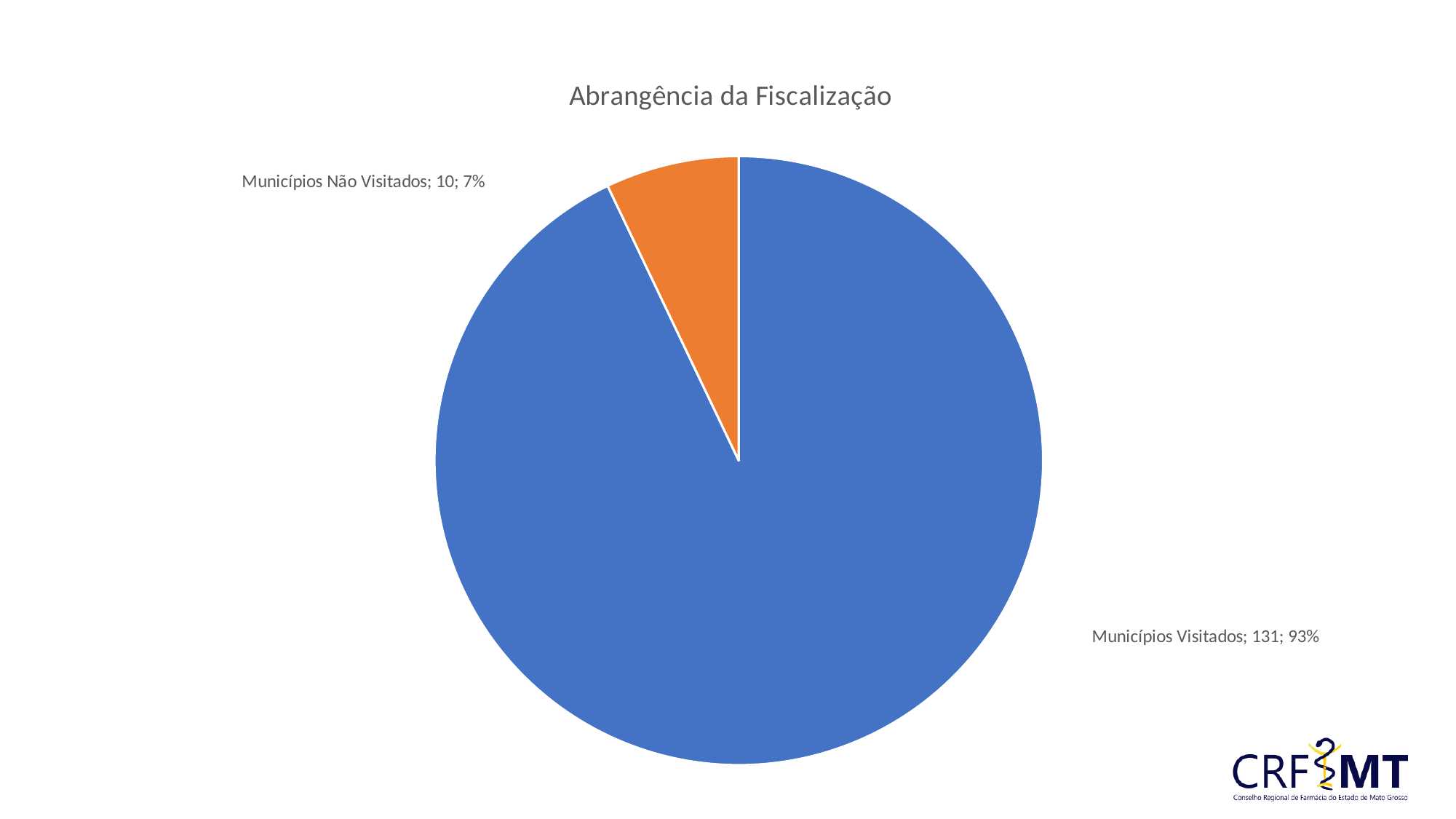
What share of the pie does Municípios Não Visitados represent? 7% What colour is the slice for Municípios Não Visitados? orange What is the difference between the values for Municípios Visitados and Municípios Não Visitados? 121 Which category has the largest slice? Municípios Visitados What is the value for Municípios Não Visitados? 10 What kind of chart is shown on the slide? pie chart What is the title of the chart? Abrangência da Fiscalização How many slices does the pie chart have? 2 What share of the pie does Municípios Visitados represent? 93% Which category has the smallest slice? Municípios Não Visitados Which is larger, Municípios Visitados or Municípios Não Visitados? Municípios Visitados What is the value for Municípios Visitados? 131